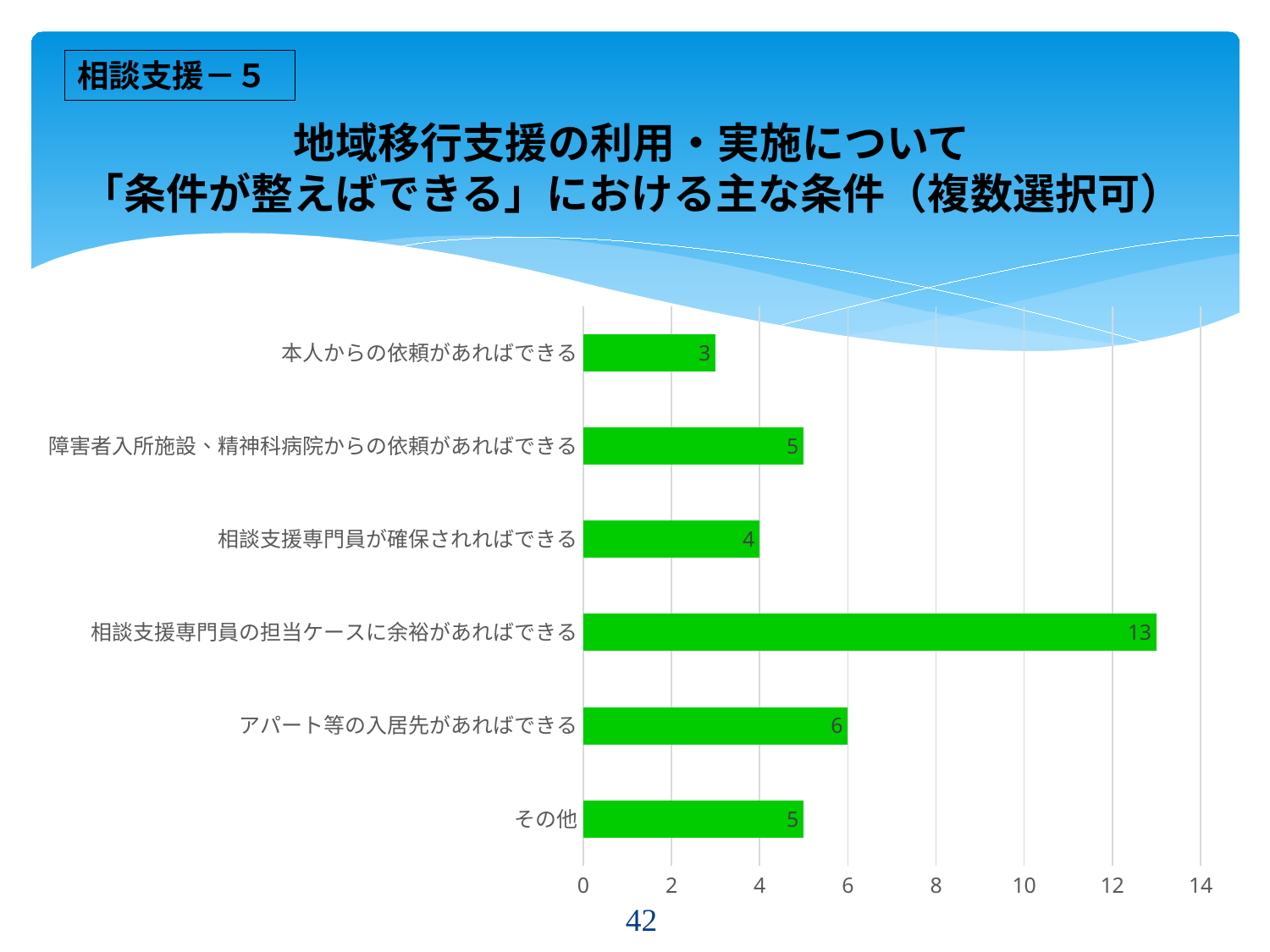
What is the value for 本人からの依頼があればできる? 3 What is the maximum value shown on the horizontal axis? 14 Is the value for 相談支援専門員の担当ケースに余裕があればできる greater or less than 10? greater Which category has the lowest value? 本人からの依頼があればできる What is the difference between the values for 相談支援専門員の担当ケースに余裕があればできる and アパート等の入居先があればできる? 7 Which is larger, the value for 障害者入所施設、精神科病院からの依頼があればできる or the value for 相談支援専門員が確保されればできる? 障害者入所施設、精神科病院からの依頼があればできる What kind of chart is shown on the slide? bar chart How many categories are shown in the chart? 6 What is the value for アパート等の入居先があればできる? 6 What is the value for 相談支援専門員が確保されればできる? 4 What is the value for 相談支援専門員の担当ケースに余裕があればできる? 13 Which category has the highest value? 相談支援専門員の担当ケースに余裕があればできる